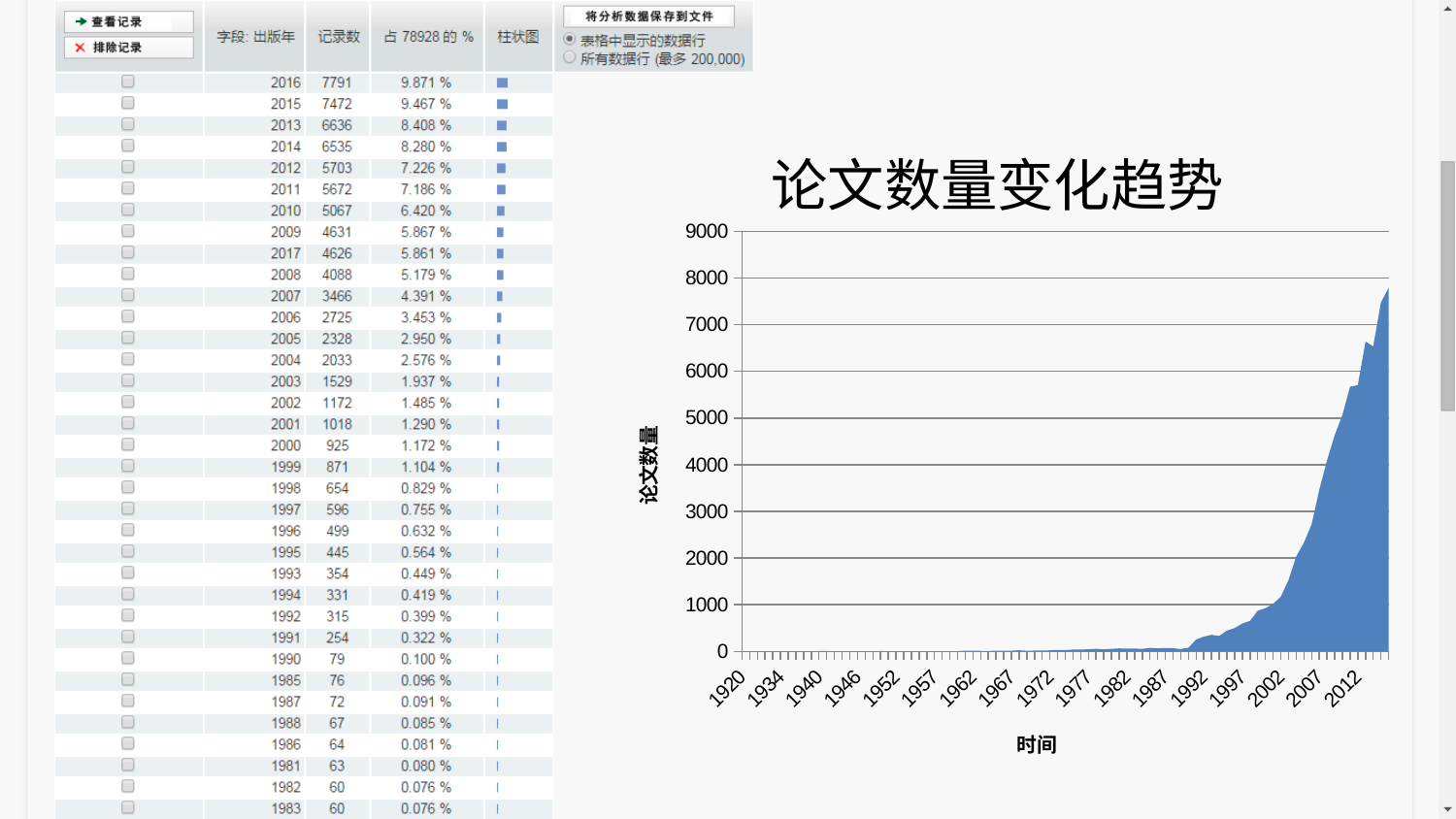
Is the highest point of the chart greater or less than 8000? less Which is larger in the chart, the value for 2002 or the value for 2012? 2012 Is the value for 1992 in the chart greater or less than 1000? less What type of chart is shown on the right side of the slide? area chart Is the value for 2007 in the chart greater or less than 3000? greater Overall, do the values in the chart rise or fall as the years increase along the x axis? rise What is the highest value shown on the y-axis of the chart? 9000 According to the table on the left, how many records are there for 2016? 7791 What is the title of the chart on the right? 论文数量变化趋势 What is the label of the y-axis of the chart? 论文数量